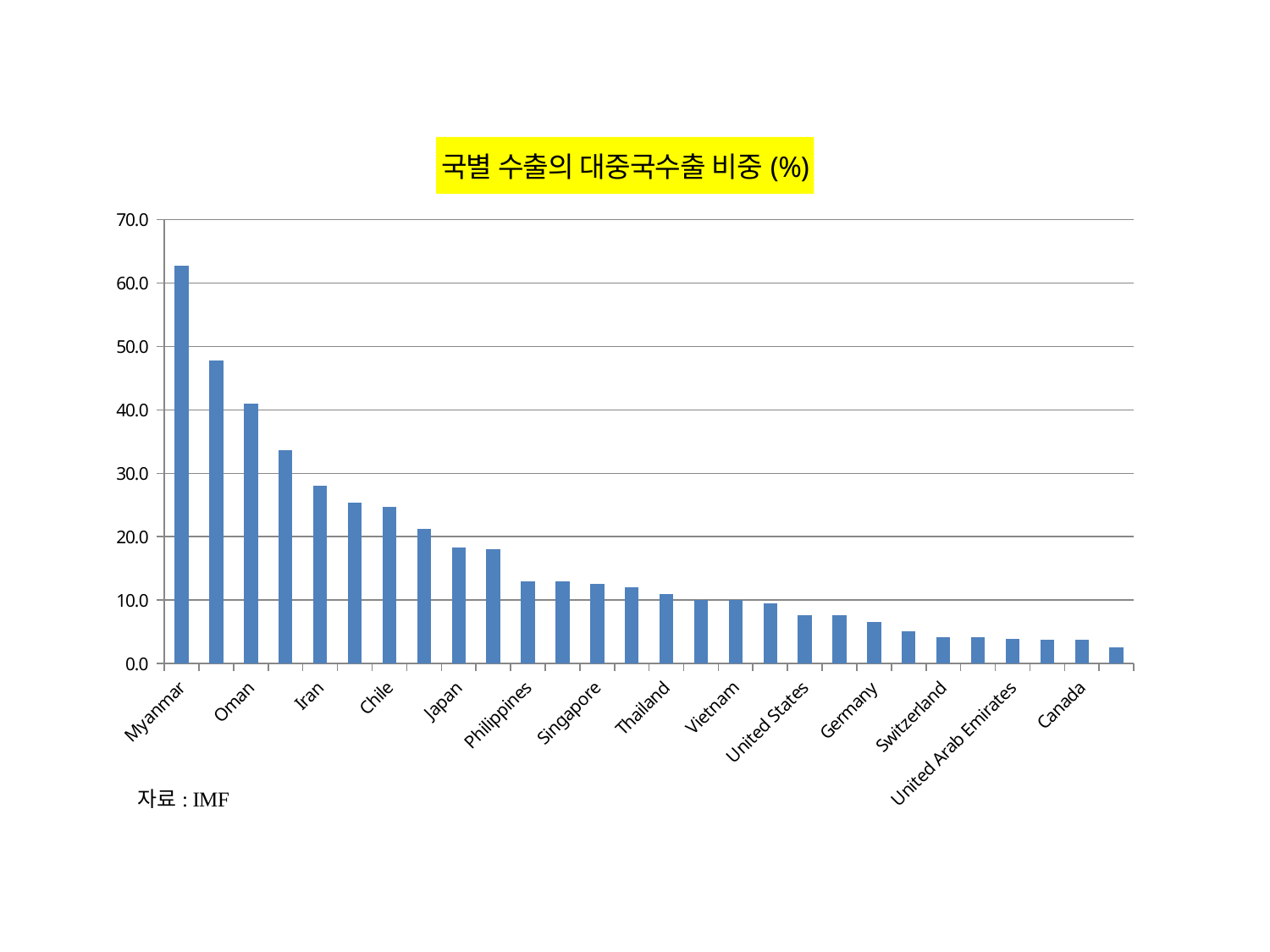
Is the value for Chile greater or less than 20? greater Which has the larger value, Germany or Philippines? Philippines Is the value for Canada greater or less than 10? less Is the value for Oman greater or less than 50? less Which country has the highest value in the chart? Myanmar What kind of chart is shown on the slide? bar chart Which has the larger value, Oman or Iran? Oman What source is cited below the chart? IMF Do the values rise or fall moving from left to right along the x axis? fall